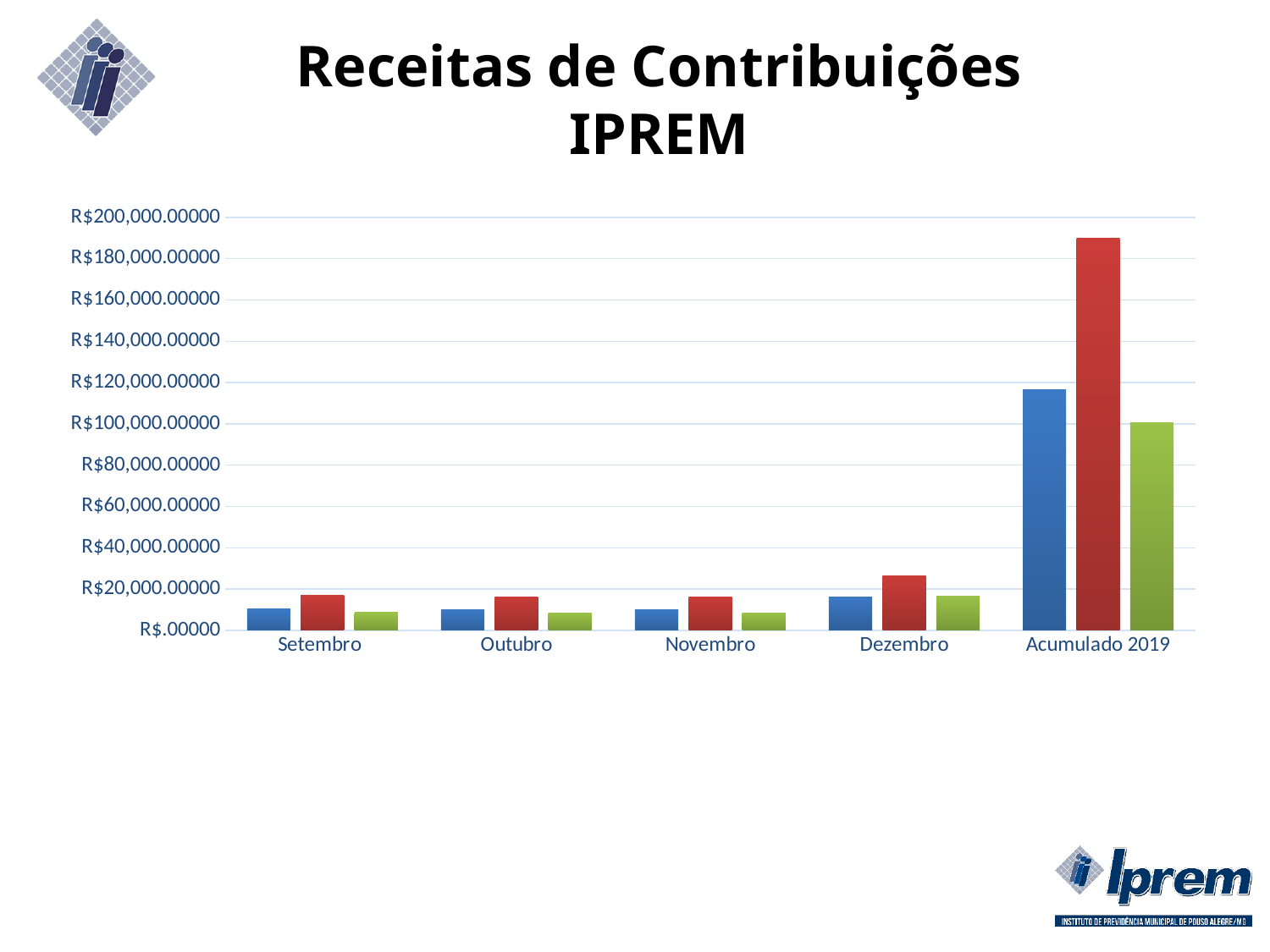
Which category has the tallest bars in the chart? Acumulado 2019 For Acumulado 2019, which is larger: the red bar or the blue bar? the red bar Is the value of the blue bar for Acumulado 2019 greater or less than R$100,000.00000? greater What is the title of the chart on the slide? Receitas de Contribuições IPREM What kind of chart is shown on the slide? bar chart Is the value of the blue bar for Setembro greater or less than R$20,000.00000? less How many bars are shown for each category on the x axis? 3 Is the value of the red bar for Dezembro greater or less than R$20,000.00000? greater How many categories are shown on the x axis of the chart? 5 Among the months Setembro, Outubro, Novembro and Dezembro, which has the highest red bar? Dezembro